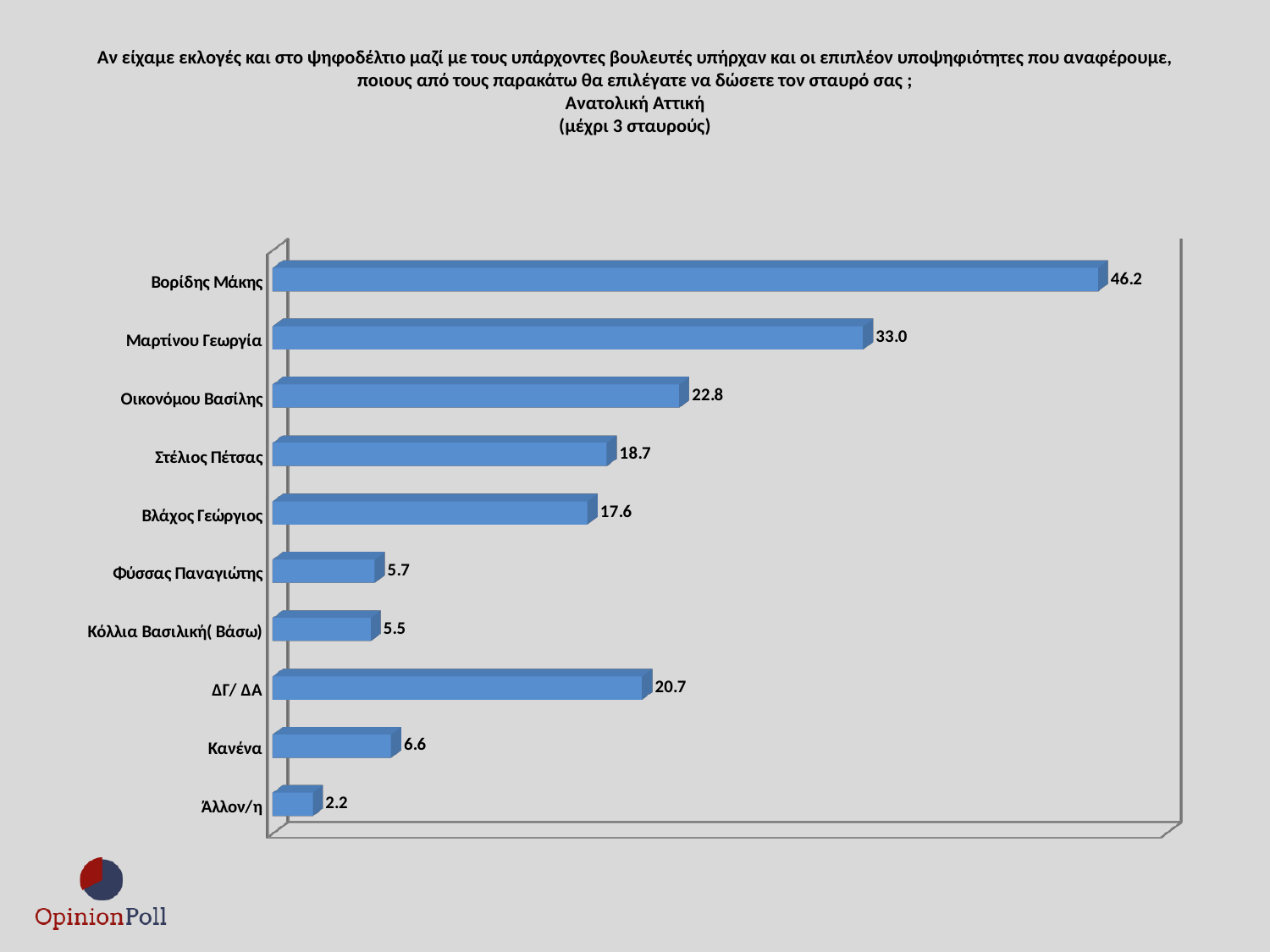
Which category has the highest value? Βορίδης Μάκης What value is shown for Βορίδης Μάκης? 46.2 Which is larger, the value for Φύσσας Παναγιώτης or the value for Κόλλια Βασιλική( Βάσω)? Φύσσας Παναγιώτης Which is larger, the value for Βλάχος Γεώργιος or the value for ΔΓ/ ΔΑ? ΔΓ/ ΔΑ What kind of chart is shown on the slide? Bar chart What value is shown for Κανένα? 6.6 How many categories are shown in the chart? 10 What is the difference between the values for Βορίδης Μάκης and Μαρτίνου Γεωργία? 13.2 Which category has the lowest value? Άλλον/η What value is shown for ΔΓ/ ΔΑ? 20.7 What is the difference between the values for Οικονόμου Βασίλης and Στέλιος Πέτσας? 4.1 What value is shown for Μαρτίνου Γεωργία? 33.0